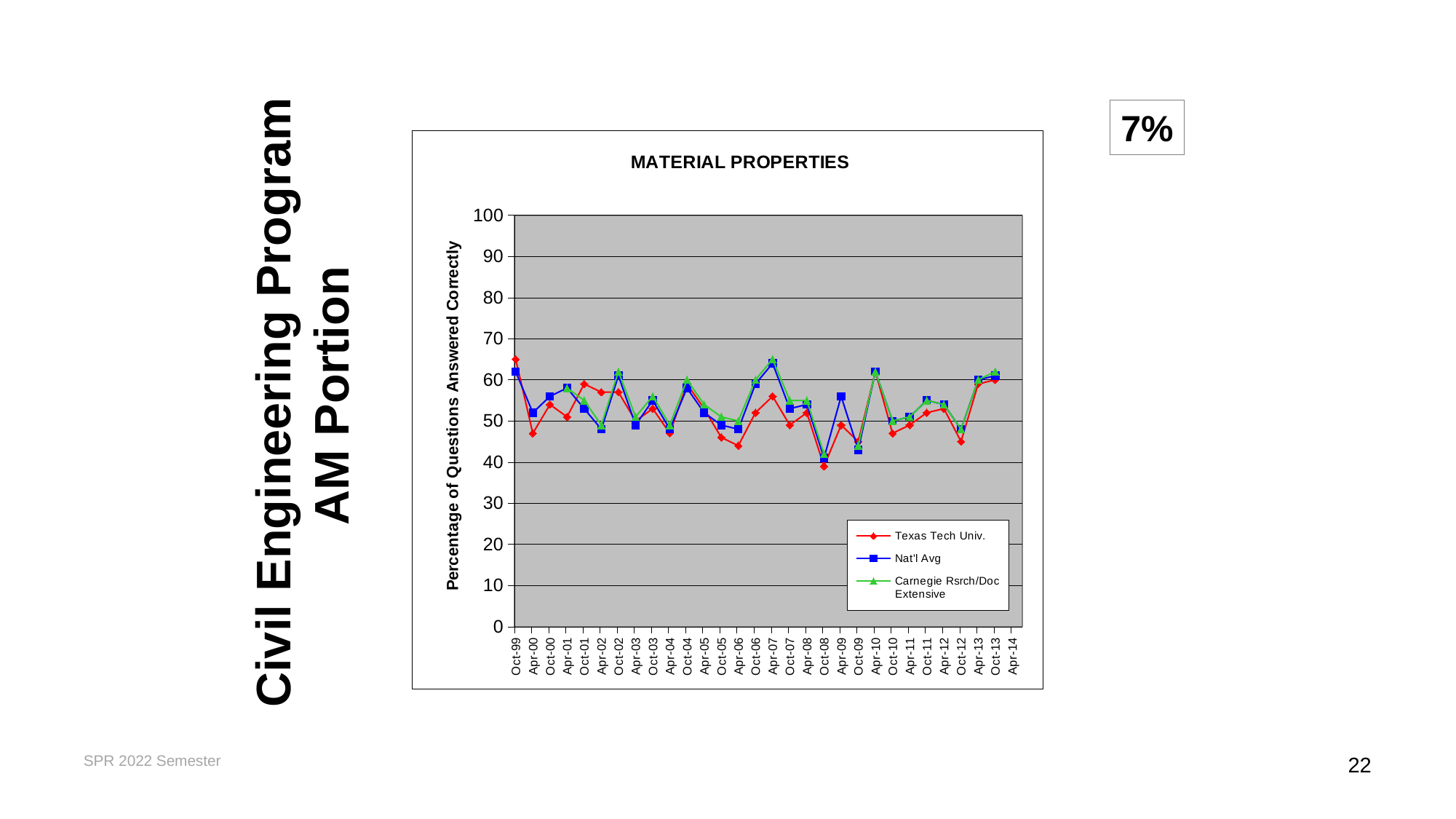
Is the Nat'l Avg value at Apr-07 greater or less than 60? greater Is the Nat'l Avg value at Oct-09 greater or less than 50? less What kind of chart is shown on the slide? Line chart At Oct-99, which series has the higher value: Texas Tech Univ. or Nat'l Avg? Texas Tech Univ. What is the label on the vertical axis of the chart? Percentage of Questions Answered Correctly At which date does the Texas Tech Univ. series reach its highest value? Oct-99 Is the Texas Tech Univ. value at Oct-99 greater or less than 60? greater How many series does the chart's legend list? 3 What is the title of the chart? MATERIAL PROPERTIES At which date does the Texas Tech Univ. series reach its lowest value? Oct-08 At Apr-09, which series has the higher value: Texas Tech Univ. or Nat'l Avg? Nat'l Avg